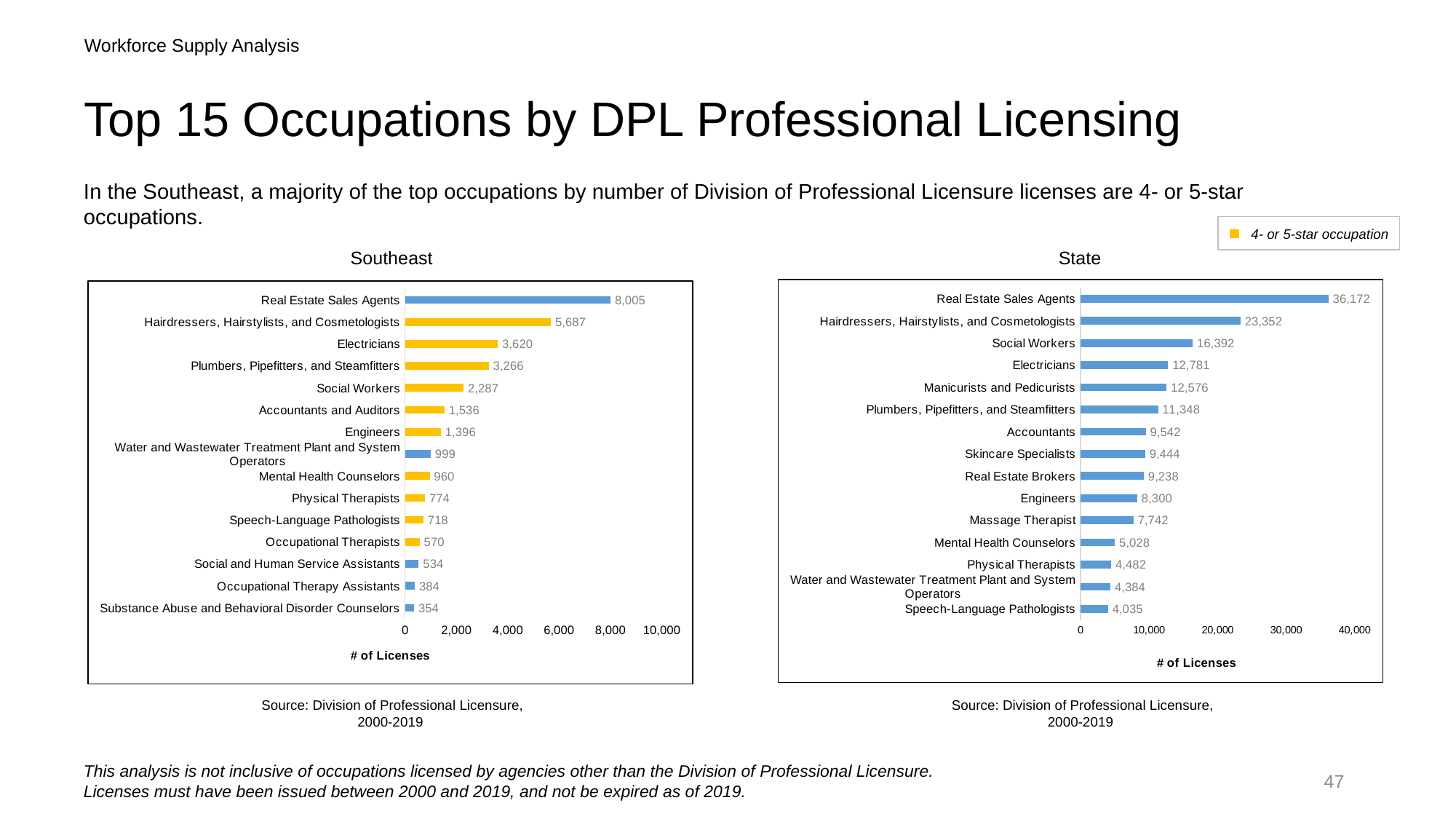
In the State chart, how many licenses are shown for Social Workers? 16,392 In the State chart, how many licenses are shown for Speech-Language Pathologists? 4,035 In the Southeast chart, how many licenses are shown for Real Estate Sales Agents? 8,005 In the Southeast chart, what is the difference in licenses between Electricians and Plumbers, Pipefitters, and Steamfitters? 354 How many occupations are plotted in the Southeast chart? 15 What type of chart is the State chart? Bar chart In the State chart, which occupation has the most licenses? Real Estate Sales Agents In the Southeast chart, which occupation has the fewest licenses? Substance Abuse and Behavioral Disorder Counselors According to the legend, what does the yellow bar colour indicate? 4- or 5-star occupation In the State chart, which has more licenses: Manicurists and Pedicurists or Plumbers, Pipefitters, and Steamfitters? Manicurists and Pedicurists In the Southeast chart, which has more licenses: Physical Therapists or Speech-Language Pathologists? Physical Therapists In the State chart, what is the difference in licenses between Real Estate Sales Agents and Hairdressers, Hairstylists, and Cosmetologists? 12,820